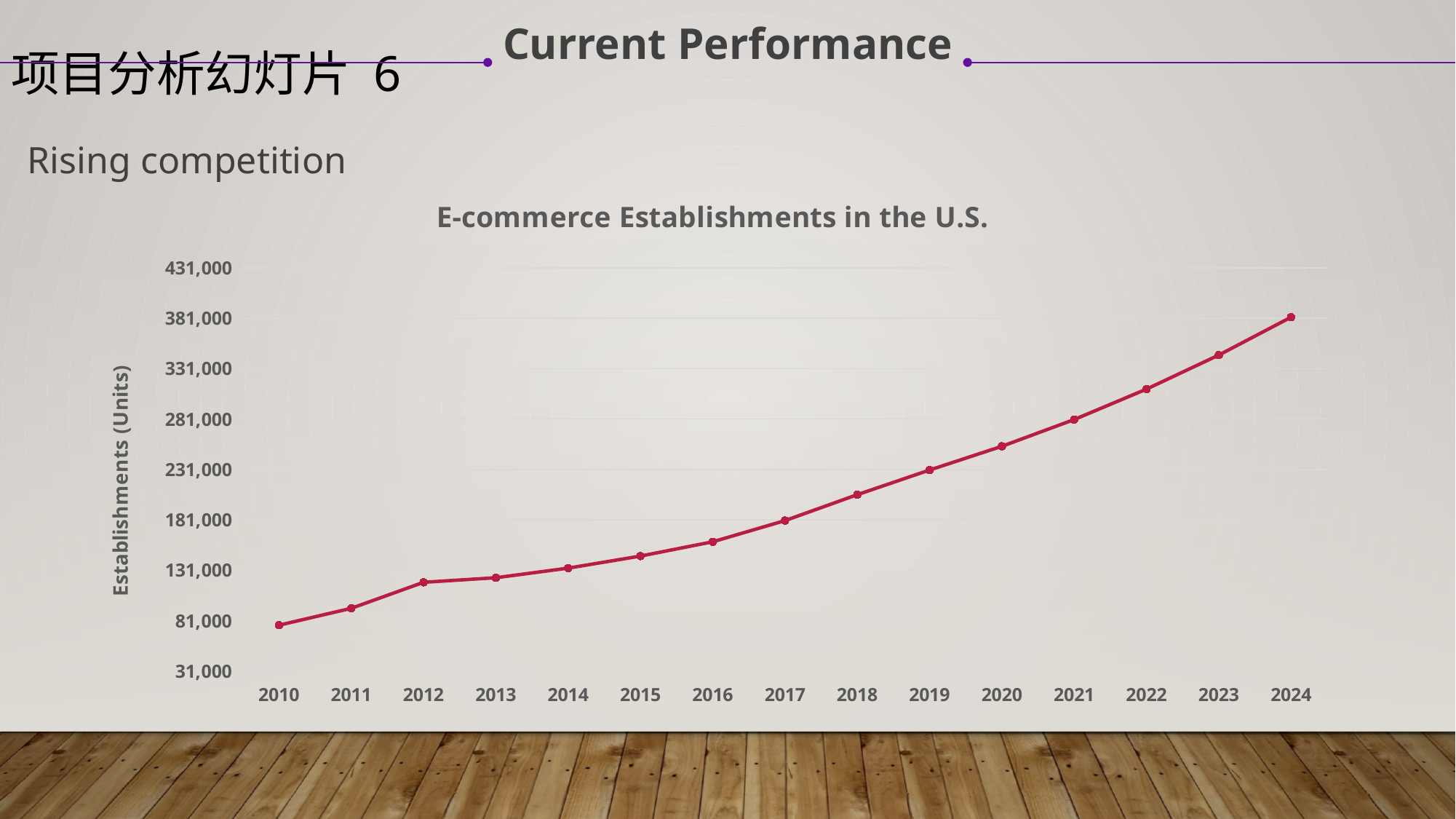
Is the value for 2023 greater or less than 331,000? greater Is the value for 2012 greater or less than 131,000? less Do the values rise or fall from 2010 to 2024? Rise What kind of chart is shown on the slide? Line chart Which year has more e-commerce establishments, 2015 or 2020? 2020 What is the label on the vertical axis of the chart? Establishments (Units) What is the title of the chart? E-commerce Establishments in the U.S. Which year has the lowest number of e-commerce establishments? 2010 How many years are plotted on the x axis of the chart? 15 Is the value for 2010 greater or less than 81,000? less Which year has the highest number of e-commerce establishments? 2024